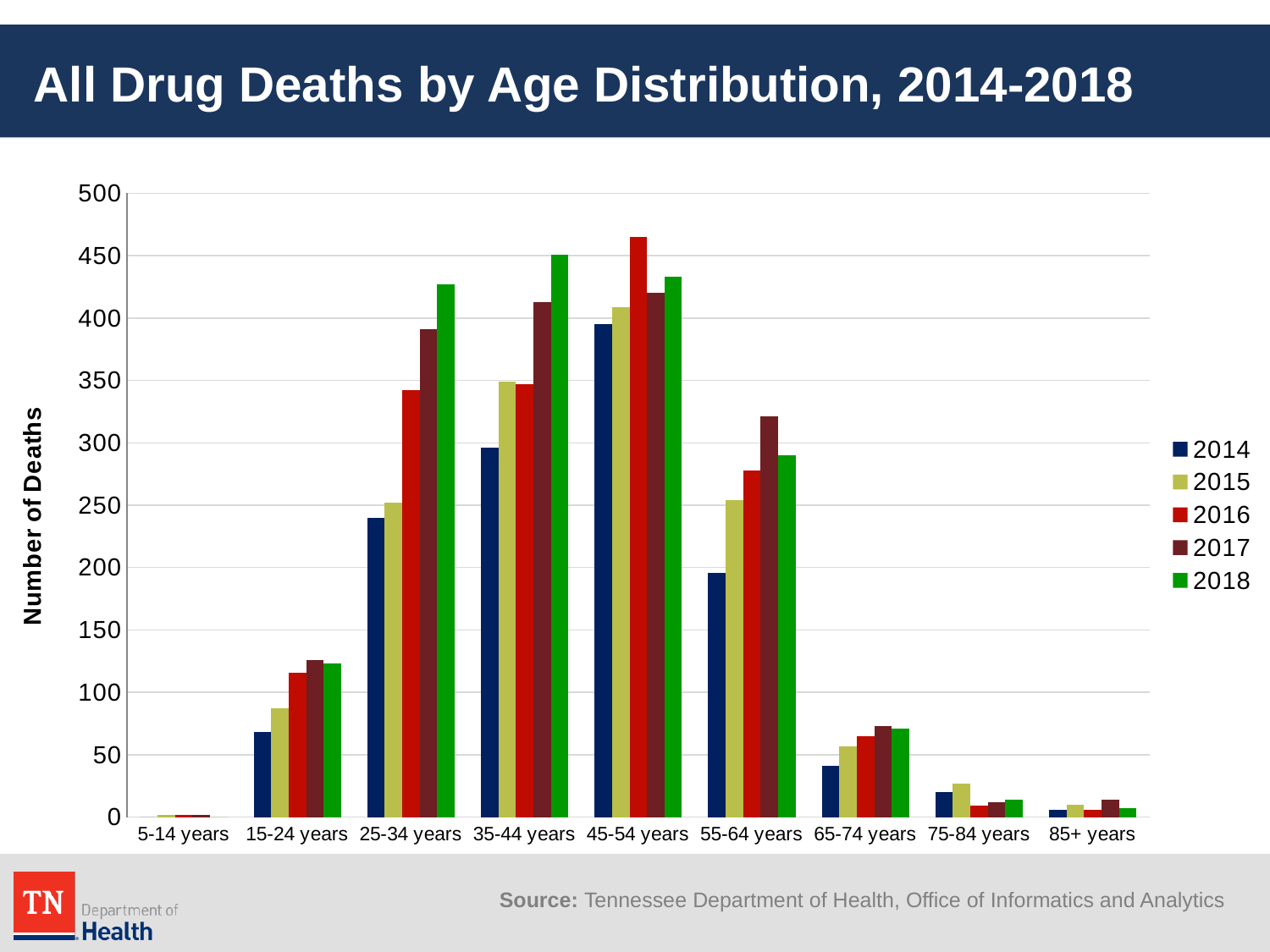
Is the 2018 value for 25-34 years greater or less than 400? greater Which age group has the lowest number of deaths for 2018? 5-14 years For the 45-54 years group, which is larger: the 2016 value or the 2017 value? 2016 What is the title of the y axis? Number of Deaths For the 35-44 years group, which is larger: the 2014 value or the 2018 value? 2018 Is the 2017 value for 55-64 years greater or less than 300? greater Which age group has the highest number of deaths for 2016? 45-54 years Is the 2014 value for 15-24 years greater or less than 100? less For the 25-34 years group, do the values rise or fall from 2014 to 2018? rise How many series does the legend list? 5 How many age groups are shown on the x axis? 9 What kind of chart is shown on the slide? bar chart